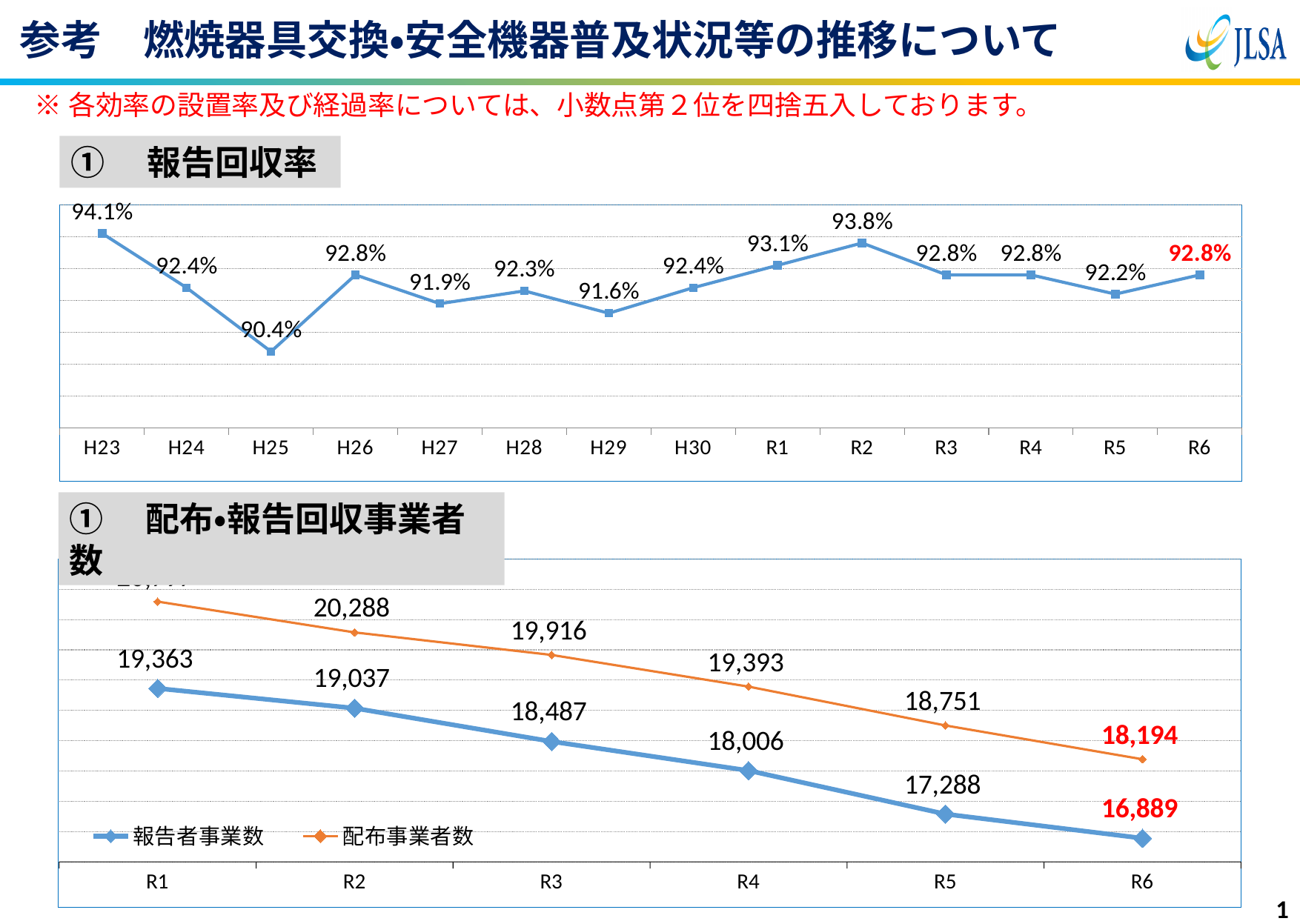
What kind of chart is the 報告回収率 chart? line chart In the 配布・報告回収事業者数 chart, how many series does the legend list? 2 In the 配布・報告回収事業者数 chart, what is the difference between 配布事業者数 and 報告者事業数 for R5? 1,463 In the 報告回収率 chart, which year has the highest value? H23 In the 配布・報告回収事業者数 chart, do the values of 報告者事業数 rise or fall from R1 to R6? fall In the 報告回収率 chart, what is the value for H23? 94.1% In the 報告回収率 chart, how many years are plotted on the x axis? 14 In the 報告回収率 chart, which year has the lowest value? H25 In the 配布・報告回収事業者数 chart, what is the value of 配布事業者数 for R6? 18,194 In the 報告回収率 chart, what is the value for R6? 92.8% In the 配布・報告回収事業者数 chart, what is the value of 報告者事業数 for R3? 18,487 In the 報告回収率 chart, what is the difference between the values for R2 and R5? 1.6%